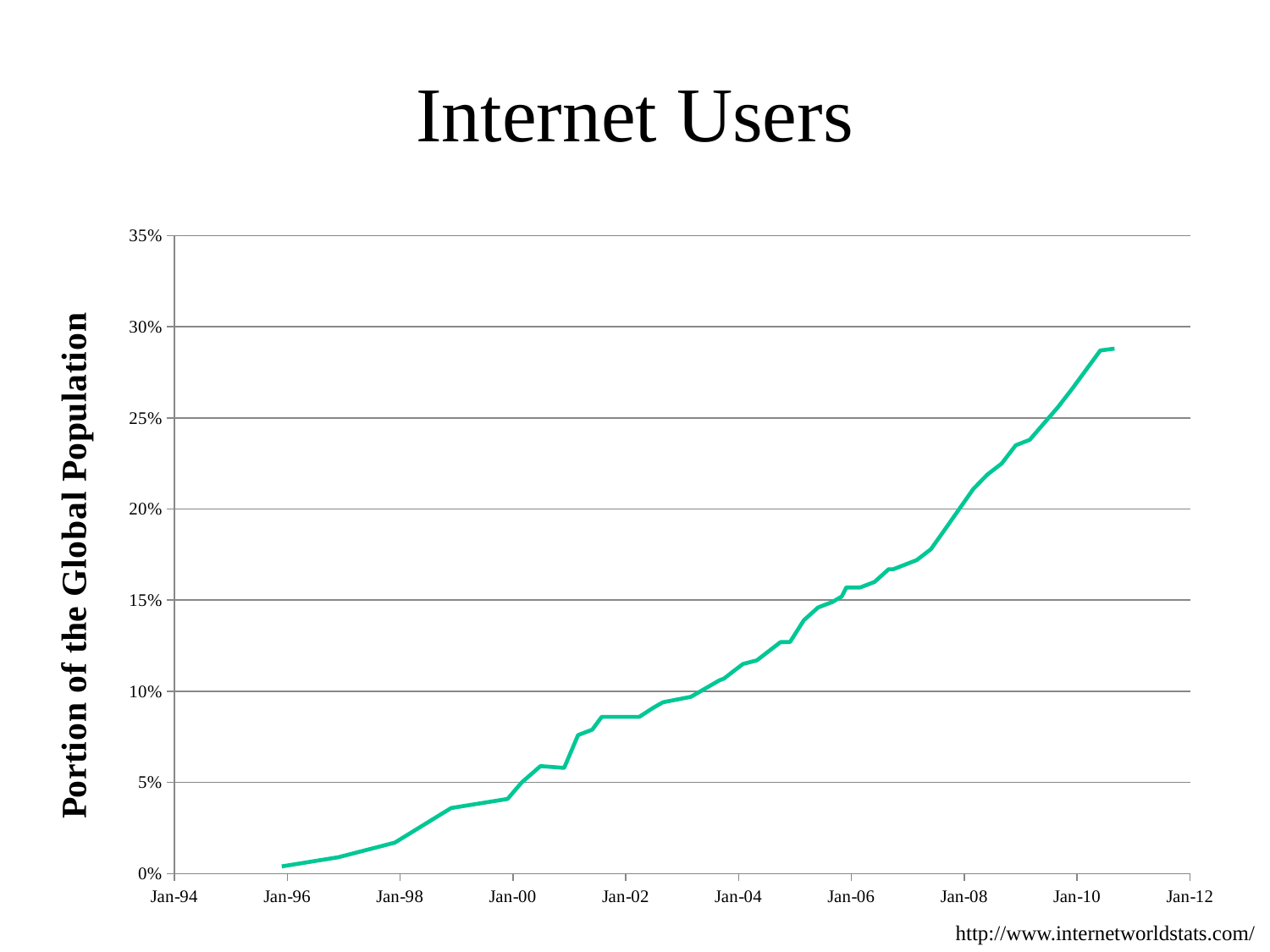
Is the value at Jan-04 greater or less than 10%? greater Is the value at Jan-98 greater or less than 5%? less What is the label on the vertical axis of the chart? Portion of the Global Population Do the values in the chart generally rise or fall from Jan-96 to the end of the line? rise Which is larger, the value at Jan-06 or the value at Jan-02? Jan-06 What is the highest tick value shown on the vertical axis? 35% Is the value at Jan-00 greater or less than 5%? less What kind of chart is shown on the slide? line chart What is the title of the chart? Internet Users